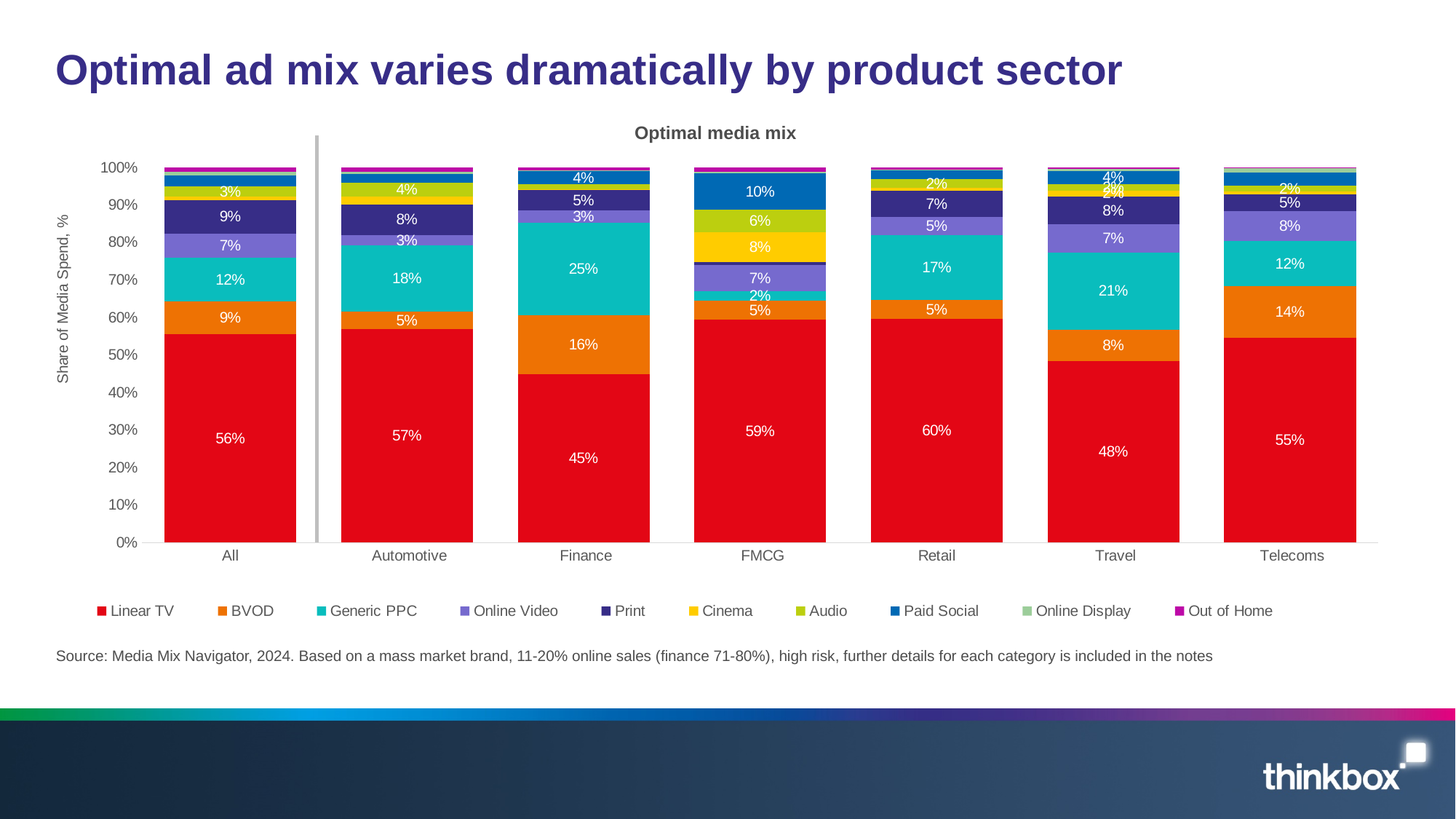
Which sector has the highest Linear TV share? Retail What is the BVOD share for Telecoms? 14% Which has a larger BVOD share, Finance or Automotive? Finance Which sector has the lowest Linear TV share? Finance What kind of chart is shown on the slide? Stacked bar chart What is the Linear TV share of media spend for the Finance sector? 45% What is the Paid Social share for FMCG? 10% How many series does the legend list? 10 What is the Generic PPC share for the Travel sector? 21% How many percentage points higher is the Generic PPC share for Finance than for All? 13 percentage points How many sectors (categories) are shown on the x axis? 7